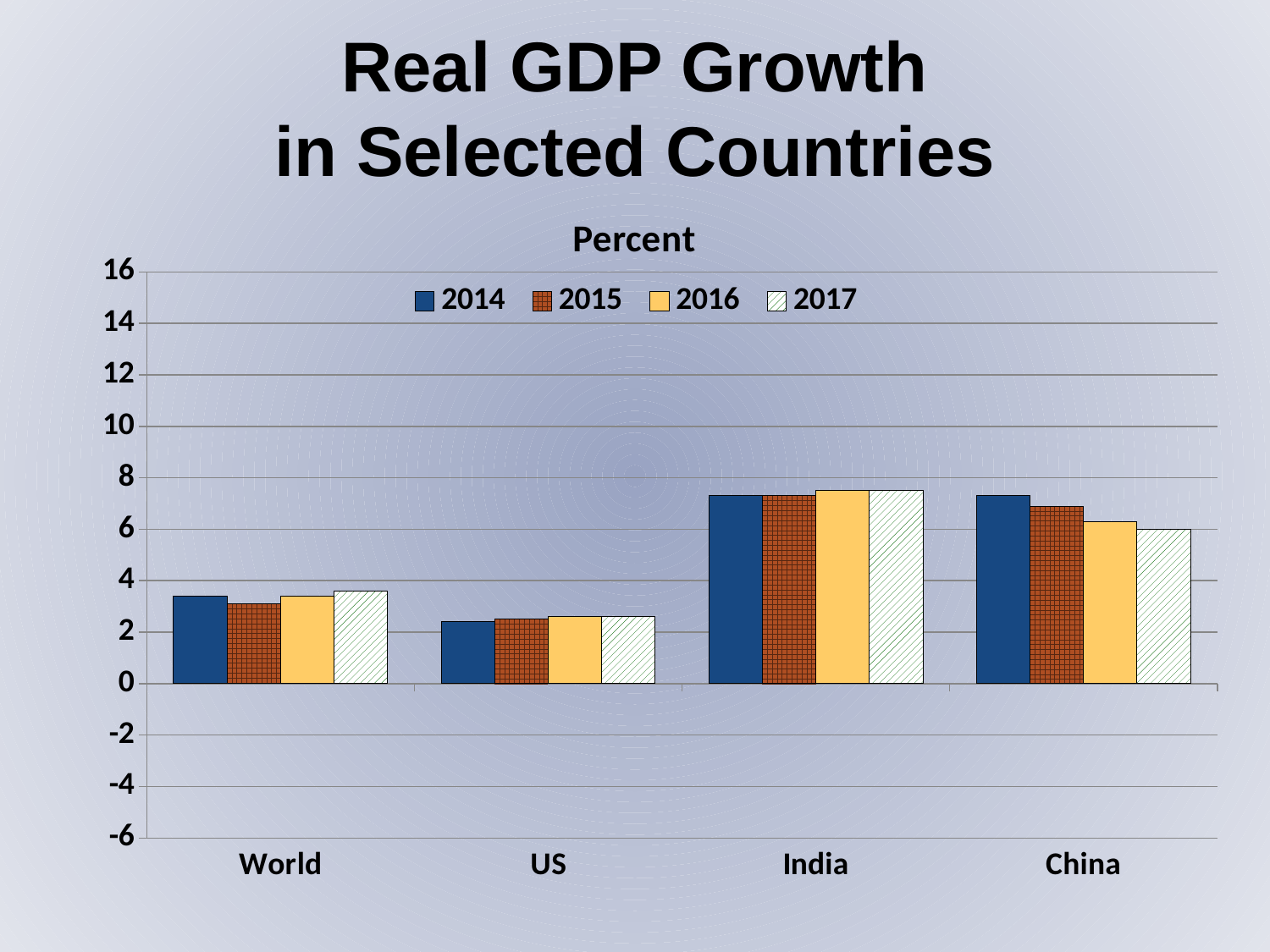
How many series does the legend list? 4 How many countries or regions are shown on the x axis? 4 What kind of chart is shown on the slide? bar chart Do the values for China rise or fall from 2014 to 2017? fall Is the value for China in 2017 greater or less than 8? less Which country or region has the highest value for 2017? India For 2016, which is larger: the value for India or the value for US? India Which country or region has the lowest value for 2014? US For China, which is larger: the 2014 value or the 2017 value? 2014 Is the value for India in 2016 greater or less than 6? greater Is the value for US in 2014 greater or less than 4? less What are the entries listed in the legend? 2014, 2015, 2016, 2017